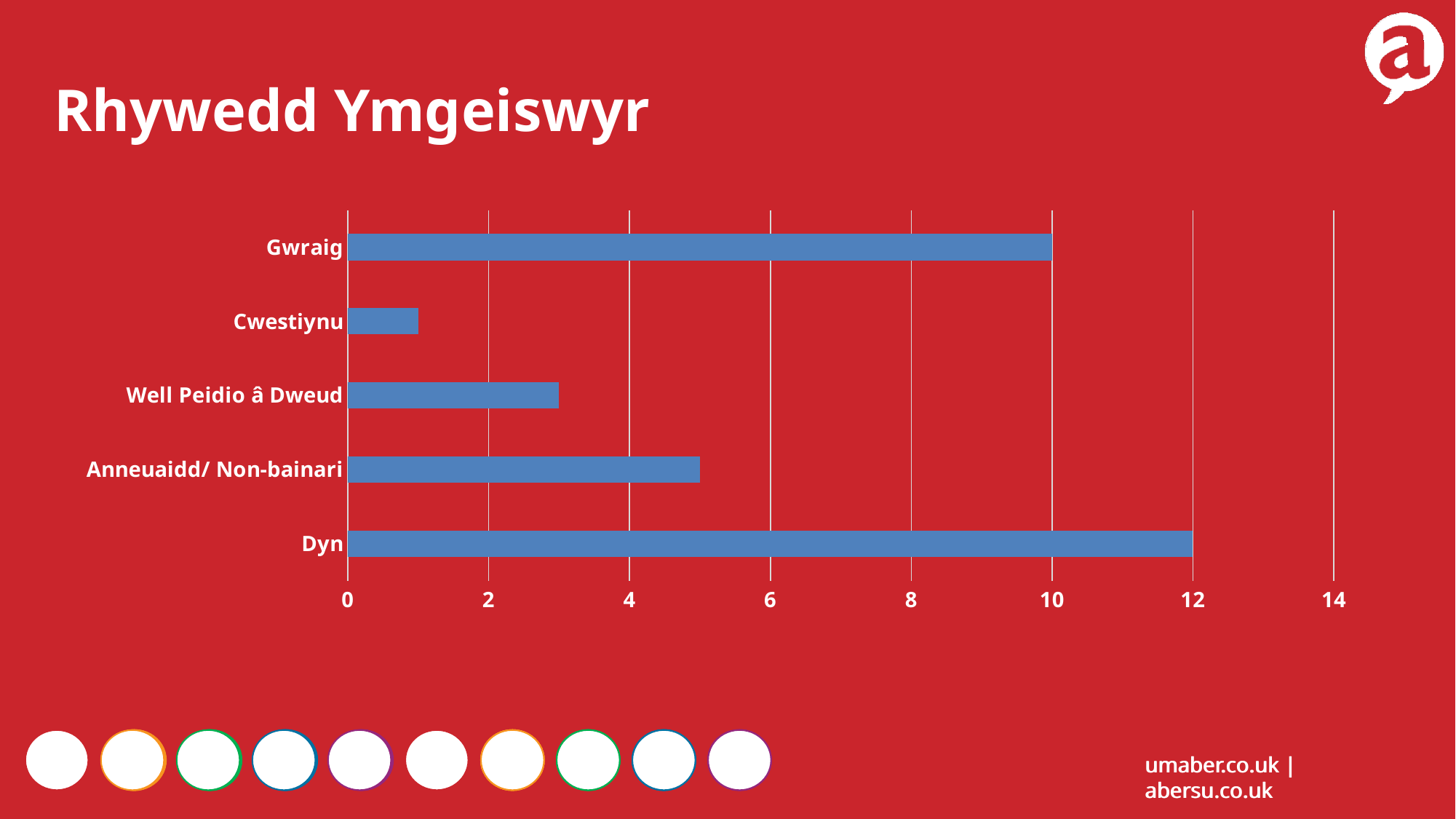
Which category has the highest value? Dyn What is the value for Gwraig? 10 Which is larger, the value for Anneuaidd/ Non-bainari or the value for Well Peidio â Dweud? Anneuaidd/ Non-bainari Is the value for Cwestiynu greater or less than 2? less What is the title of the chart? Rhywedd Ymgeiswyr What is the value for Dyn? 12 Which category has the lowest value? Cwestiynu Is the value for Anneuaidd/ Non-bainari greater or less than 4? greater Is the value for Well Peidio â Dweud greater or less than 4? less What type of chart is shown on the slide? bar chart How many categories are shown in the chart? 5 What is the difference between the values for Dyn and Gwraig? 2